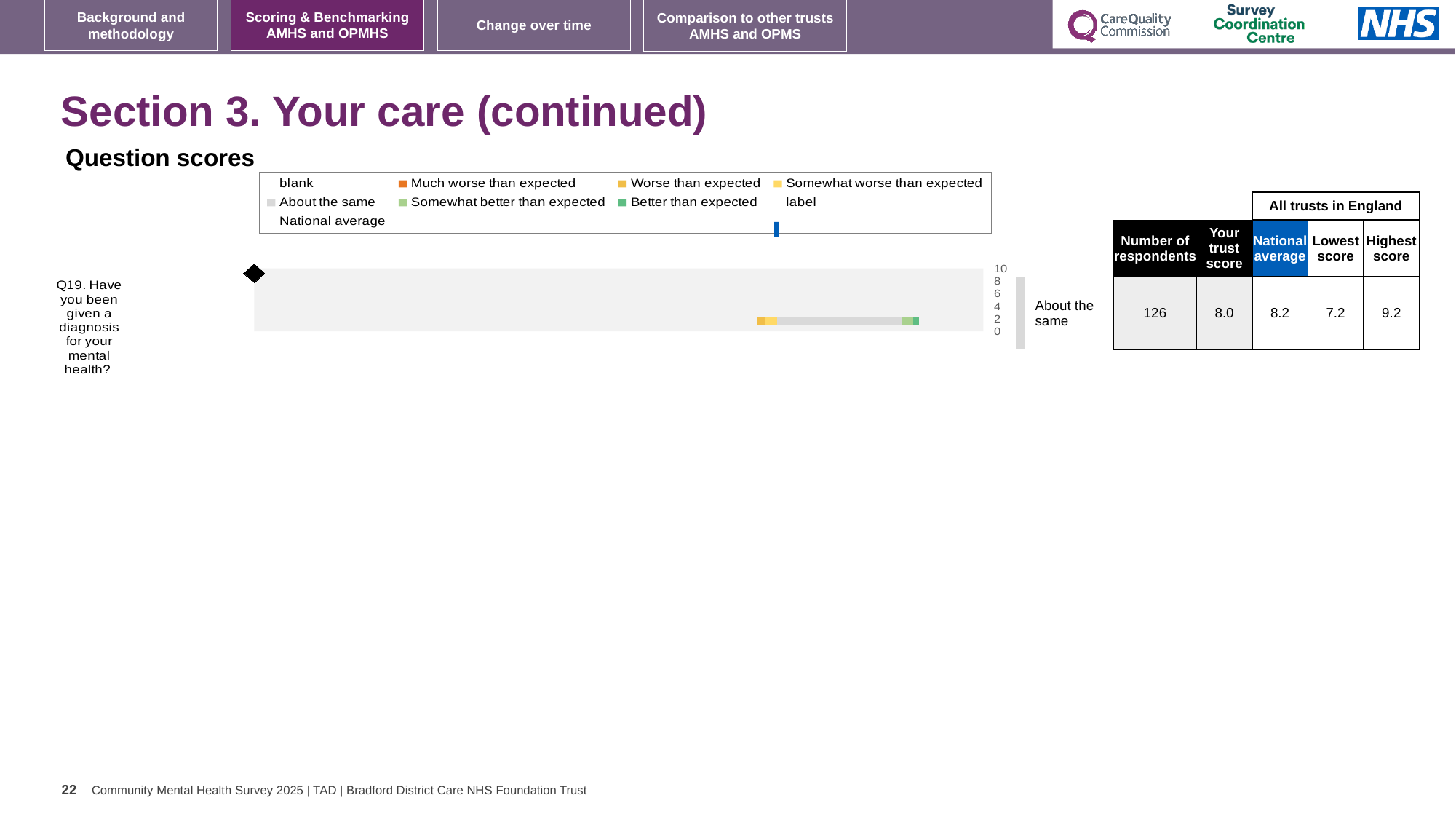
Which is larger for Q19, the trust's score or the national average? national average What is the highest score among all trusts in England for Q19? 9.2 What is the difference between the national average and the trust's score for Q19? 0.2 Which question is shown in the question scores chart? Q19. Have you been given a diagnosis for your mental health? What is the benchmark rating shown next to the bar for Q19? About the same How many questions are plotted in the question scores chart? 1 What kind of chart is used to show the question scores on this slide? bar chart What is the trust's score for Q19? 8.0 What is the national average score for Q19? 8.2 How many respondents answered Q19? 126 What is the difference between the highest and lowest scores for Q19 across all trusts in England? 2.0 What is the lowest score among all trusts in England for Q19? 7.2